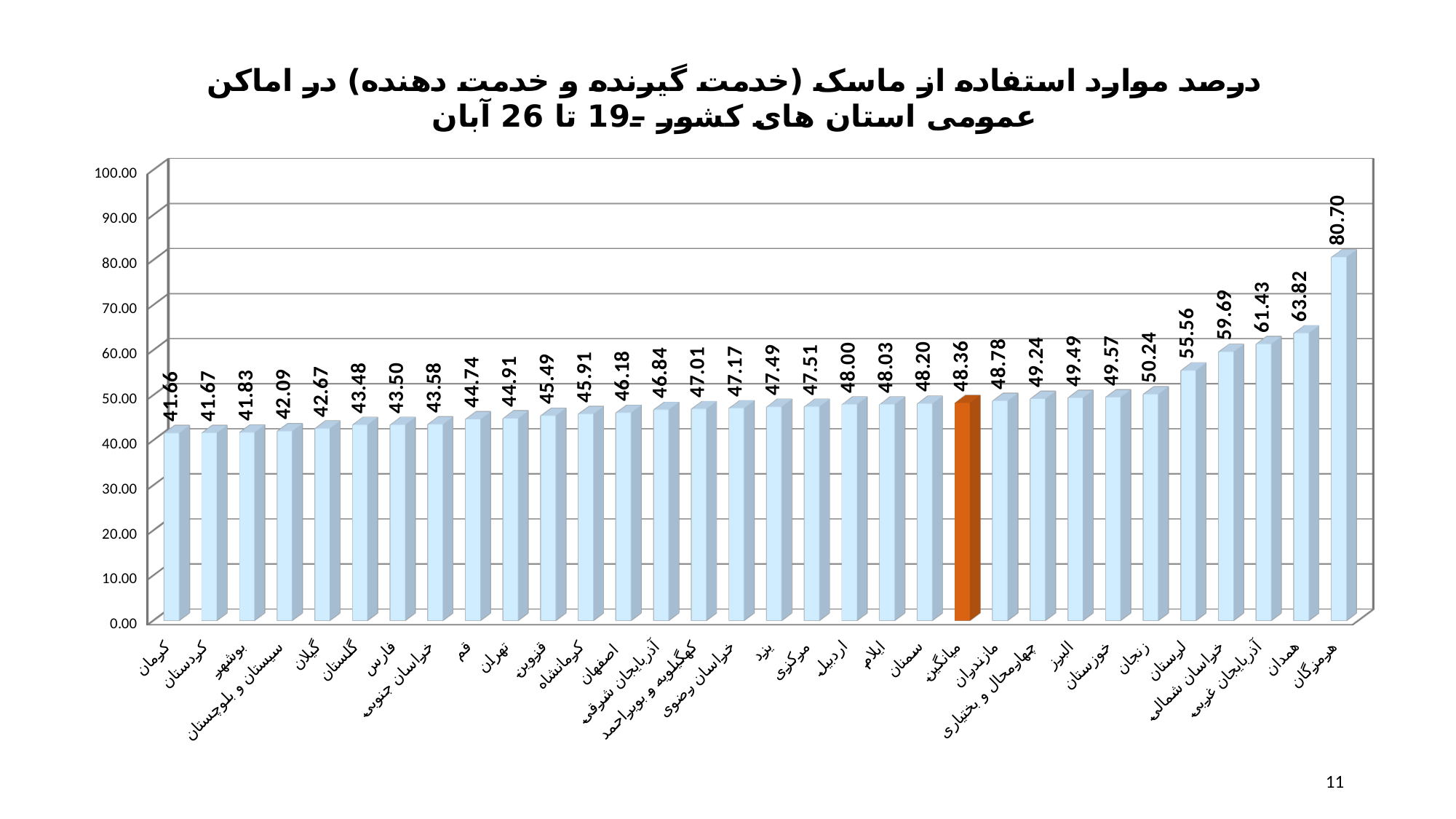
Do the values rise or fall from left to right along the x axis? rise Is the value for آذربایجان غربی greater or less than 60.00? greater Which category has the lowest value? کرمان What is the value for تهران? 44.91 What kind of chart is shown on the slide? bar chart Which category has the highest value? هرمزگان What is the value for هرمزگان? 80.70 How many bars are plotted in the chart? 32 Which bar is coloured orange instead of light blue? میانگین Which has a larger value, لرستان or زنجان? لرستان What is the value for the میانگین (average) bar? 48.36 What is the difference between the values for هرمزگان and همدان? 16.88